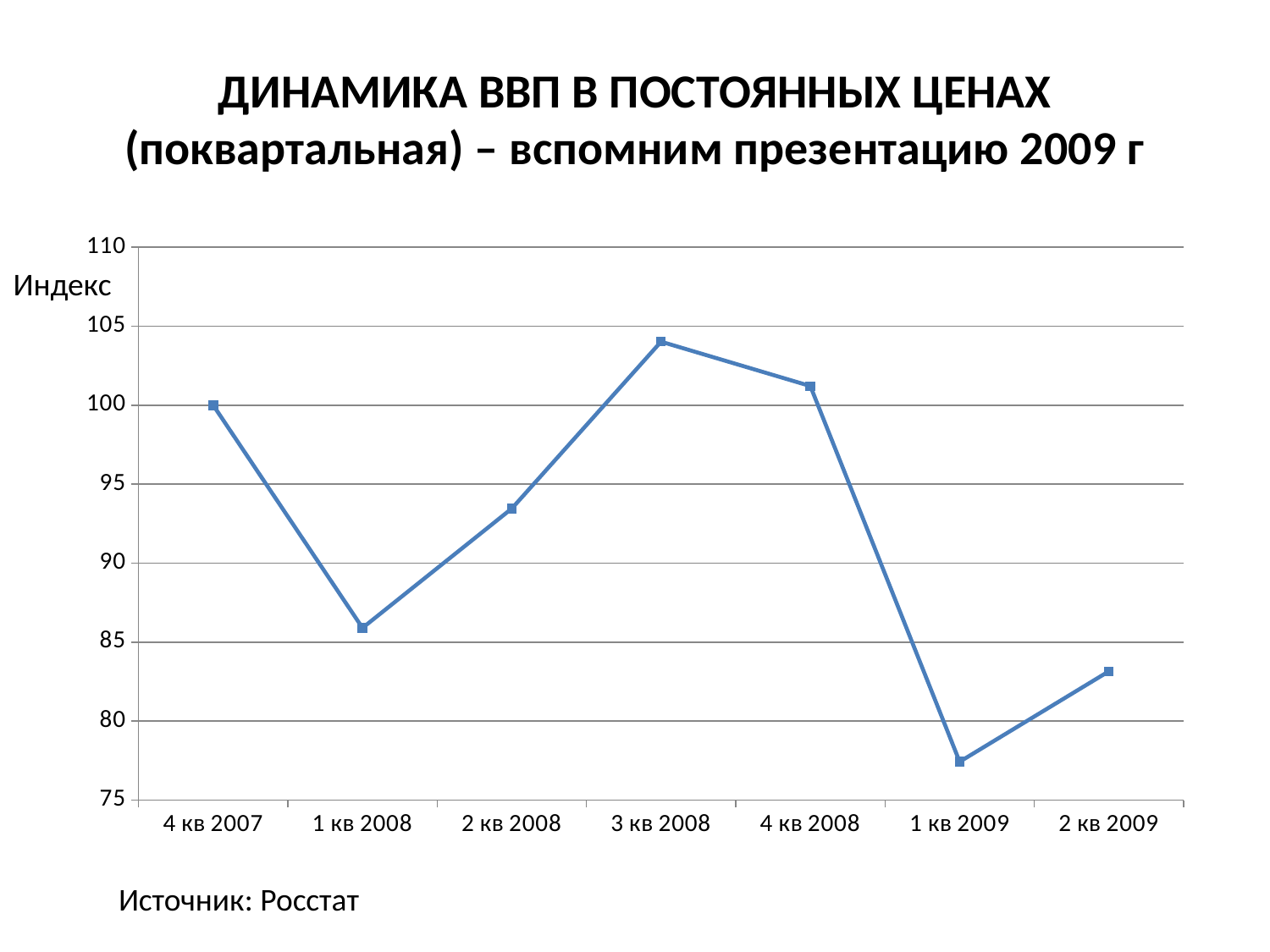
Is the value for 3 кв 2008 greater or less than 100? greater How many quarters are plotted on the x axis? 7 Is the value for 1 кв 2008 greater or less than 90? less Which is larger, the value for 4 кв 2008 or the value for 2 кв 2008? 4 кв 2008 Which quarter has the highest index value? 3 кв 2008 Is the value for 2 кв 2009 greater or less than 85? less Does the index rise or fall from 4 кв 2008 to 1 кв 2009? fall What kind of chart is shown on the slide? line chart What is the label on the vertical axis of the chart? Индекс Which quarter has the lowest index value? 1 кв 2009 What source is cited below the chart? Росстат